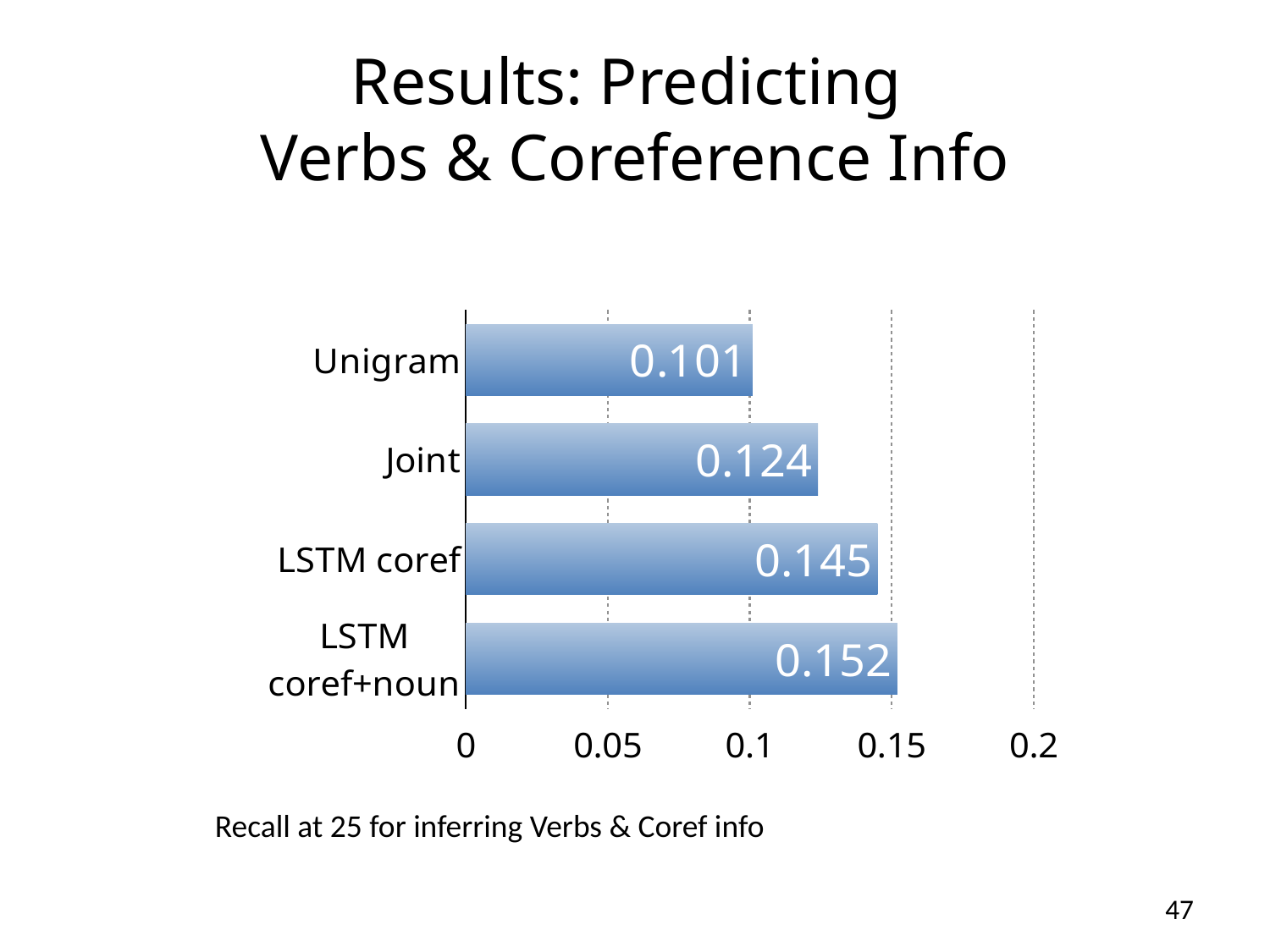
What is the value for LSTM coref? 0.145 What is the difference between the values for LSTM coref+noun and Unigram? 0.051 What kind of chart is shown on the slide? bar chart How many categories are shown in the chart? 4 Is the value for LSTM coref+noun greater or less than 0.15? greater What is the value for Unigram? 0.101 What is the difference between the values for LSTM coref and Joint? 0.021 What is the value for LSTM coref+noun? 0.152 Which is larger, the value for Joint or the value for Unigram? Joint Which category has the lowest value? Unigram What is the value for Joint? 0.124 Which category has the highest value? LSTM coref+noun